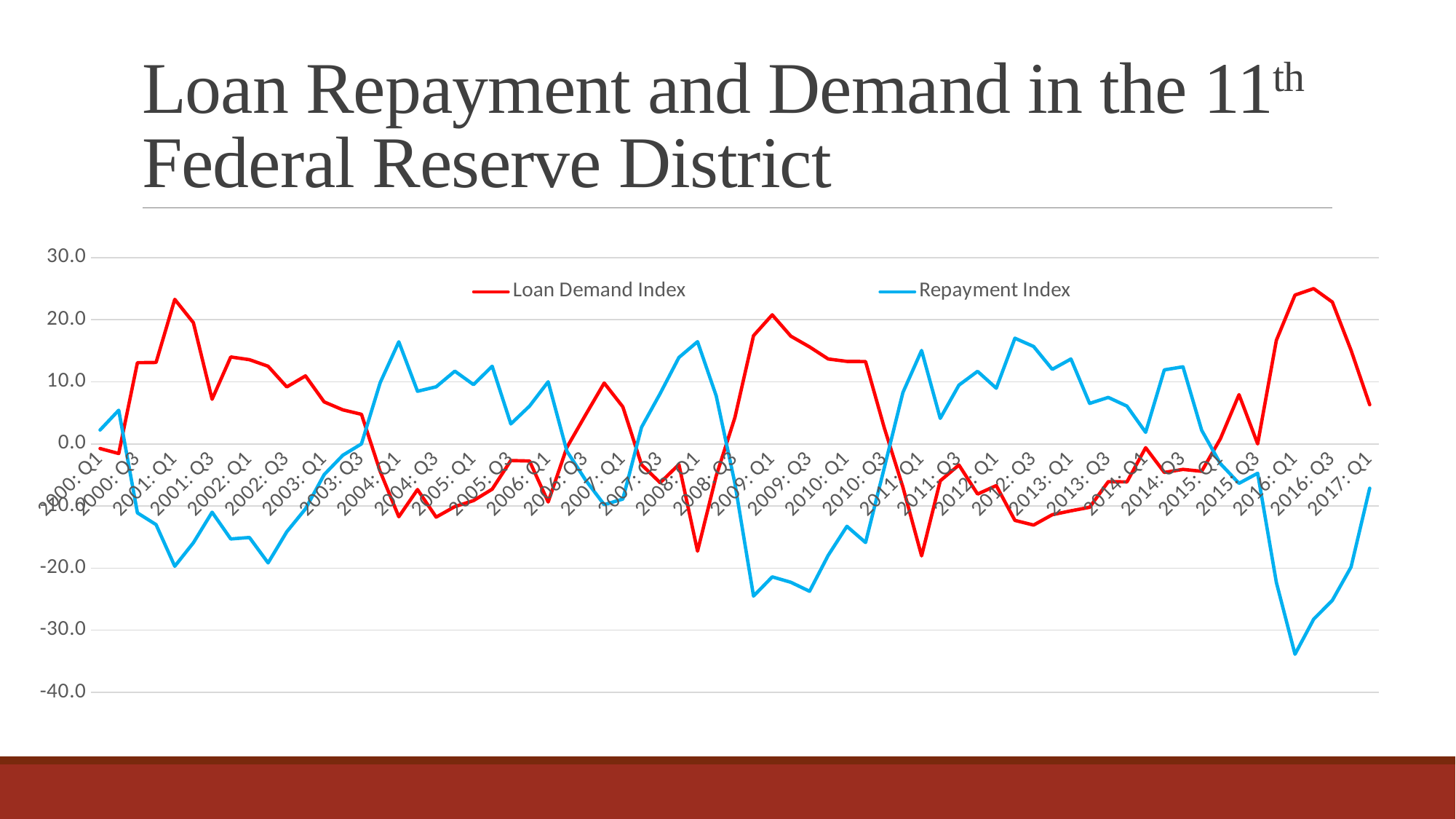
Is the Repayment Index value at 2009: Q1 greater or less than -20.0? less What is the title of the slide containing the chart? Loan Repayment and Demand in the 11th Federal Reserve District How many series does the legend list? 2 Which series is drawn in red? Loan Demand Index What kind of chart is shown on the slide? line chart Is the Loan Demand Index value at 2016: Q1 greater or less than 20.0? greater Which series reaches the lowest value anywhere on the chart? Repayment Index Is the Repayment Index value at 2004: Q1 greater or less than 10.0? greater At 2004: Q1, which series has the larger value, Loan Demand Index or Repayment Index? Repayment Index At 2016: Q1, which series has the larger value, Loan Demand Index or Repayment Index? Loan Demand Index Does the Loan Demand Index rise or fall from 2016: Q3 to 2017: Q1? fall